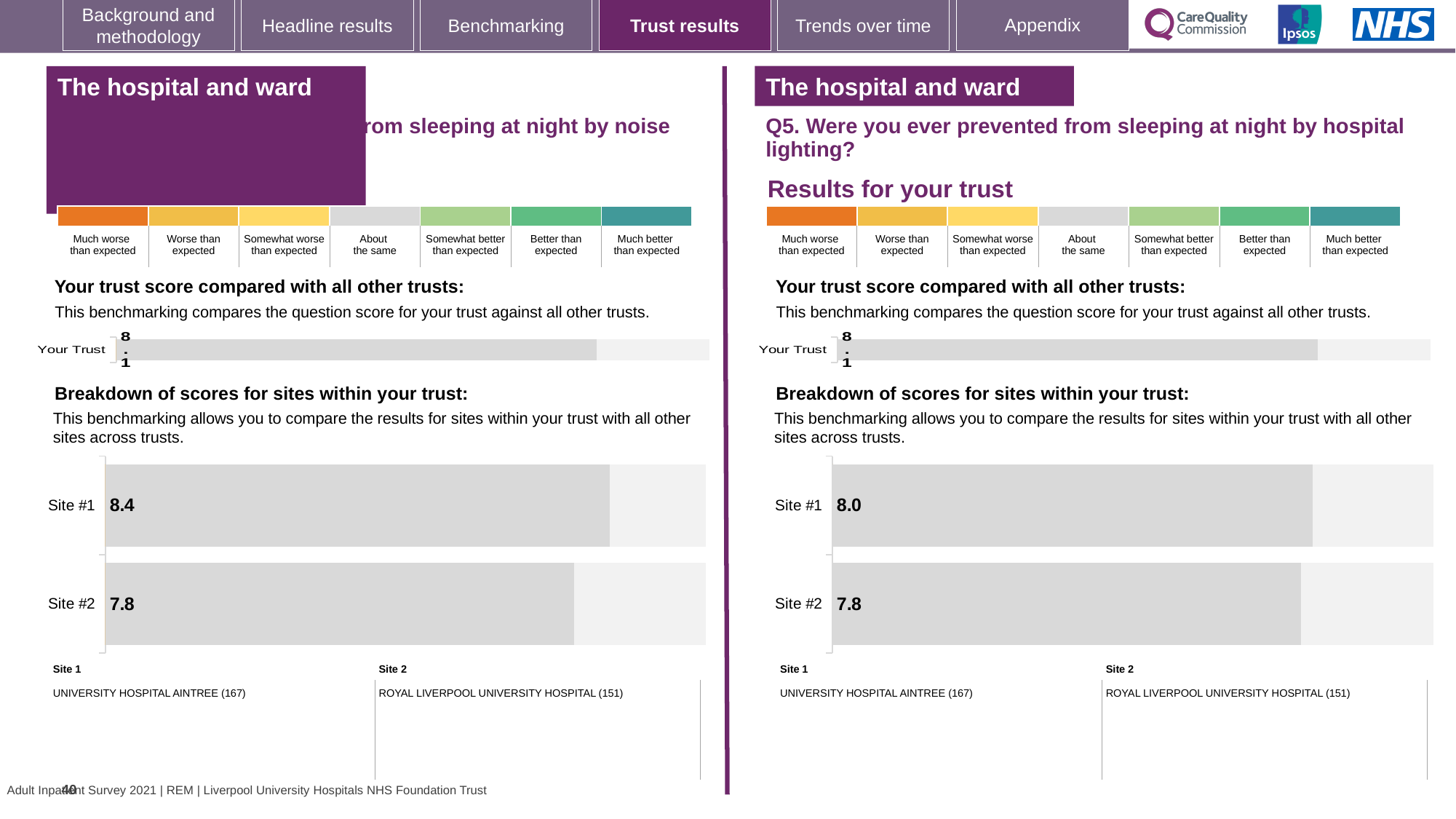
What type of chart is used for the 'Breakdown of scores for sites within your trust' on the left-hand side of the slide? Bar chart On the right-hand side of the slide (Q5, hospital lighting), in the 'Breakdown of scores for sites within your trust' chart, what is the score for Site #1? 8.0 On the right-hand side of the slide (Q5, hospital lighting), in the 'Breakdown of scores for sites within your trust' chart, what is the score for Site #2? 7.8 On the left-hand side of the slide, in the site breakdown chart, which site has the higher score? Site #1 On the left-hand side of the slide, in the site breakdown chart, what is the difference between the Site #1 and Site #2 scores? 0.6 How many sites are shown in the 'Breakdown of scores for sites within your trust' chart on the right-hand side of the slide? 2 On the left-hand side of the slide, what is the 'Your Trust' score shown in the 'Your trust score compared with all other trusts' chart? 8.1 On the right-hand side of the slide (Q5, hospital lighting), what is the 'Your Trust' score shown in the 'Your trust score compared with all other trusts' chart? 8.1 On the left-hand side of the slide, in the 'Breakdown of scores for sites within your trust' chart, what is the score for Site #2? 7.8 On the right-hand side of the slide (Q5, hospital lighting), in the site breakdown chart, which site has the lower score? Site #2 On the right-hand side of the slide (Q5, hospital lighting), in the site breakdown chart, what is the difference between the Site #1 and Site #2 scores? 0.2 On the left-hand side of the slide, in the 'Breakdown of scores for sites within your trust' chart, what is the score for Site #1? 8.4